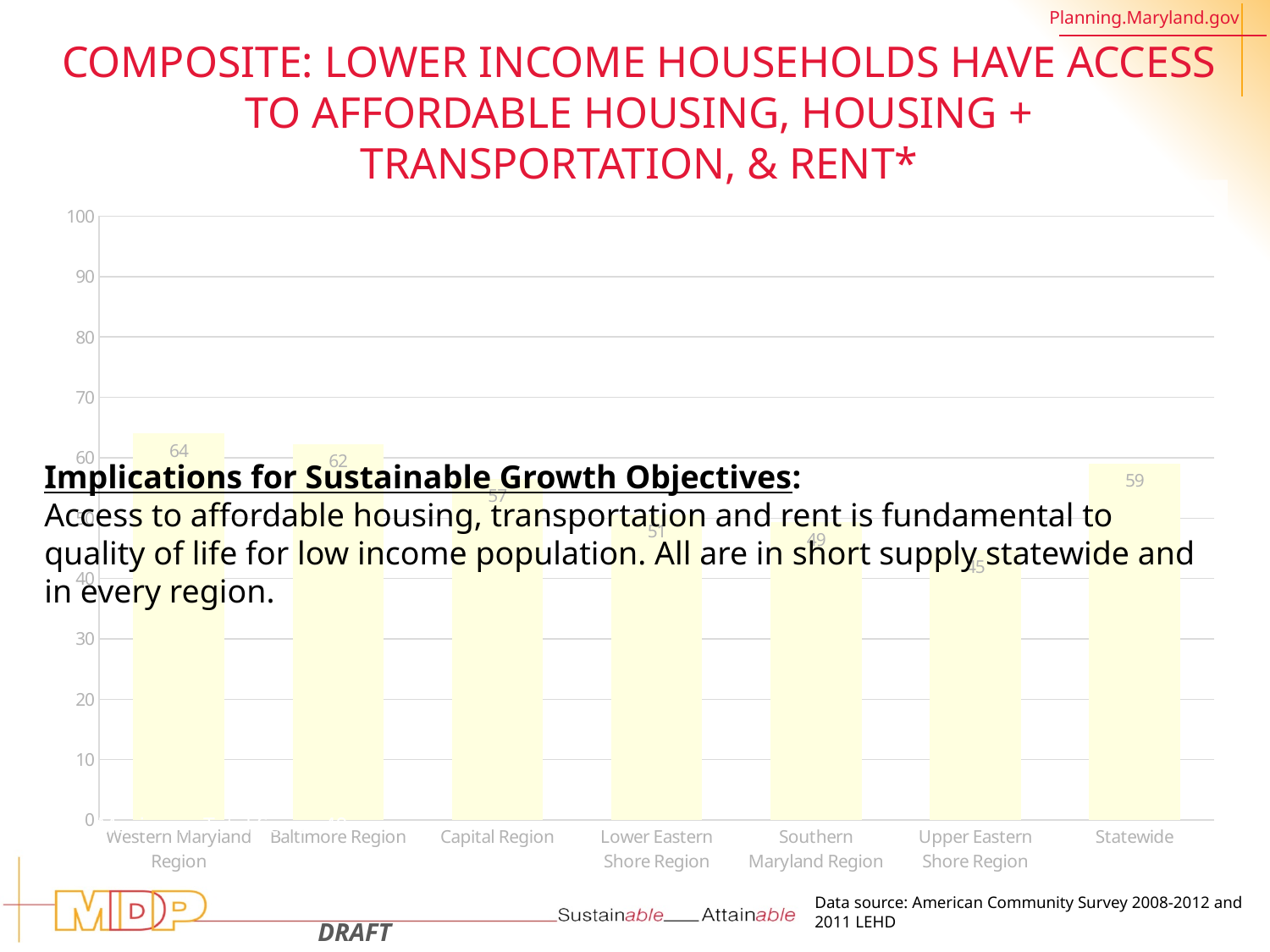
What is the value for Baltimore Region? 62 How many categories are shown on the x axis? 7 Which region has the lowest value? Upper Eastern Shore Region Which is larger, the value for Baltimore Region or the value for Capital Region? Baltimore Region What is the difference between the values for Western Maryland Region and Statewide? 5 What is the value for Western Maryland Region? 64 Which region has the highest value? Western Maryland Region What is the value for Statewide? 59 Is the value for Southern Maryland Region greater or less than 60? less What is the highest value shown on the y axis? 100 What is the value for Upper Eastern Shore Region? 45 What kind of chart is shown on the slide? bar chart